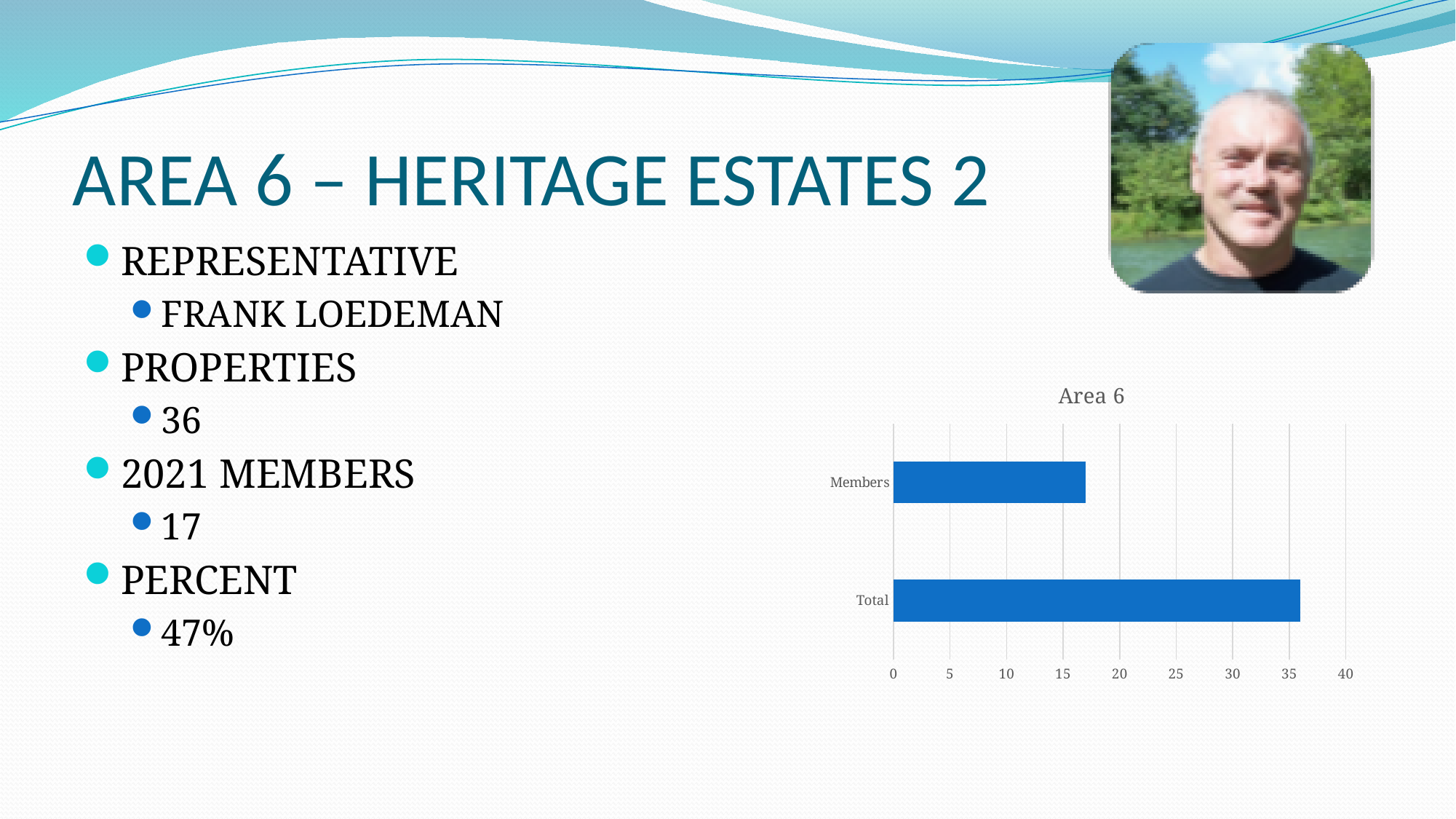
What kind of chart is shown on the slide? bar chart How many categories does the chart show? 2 What is the title of the chart? Area 6 Is the value for Members greater or less than 20? less Which is larger in the chart, Members or Total? Total Is the value for Members greater or less than 15? greater What is the highest value shown on the chart's value axis? 40 Is the value for Total greater or less than 30? greater Which category has the highest value in the chart? Total Which category has the lowest value in the chart? Members